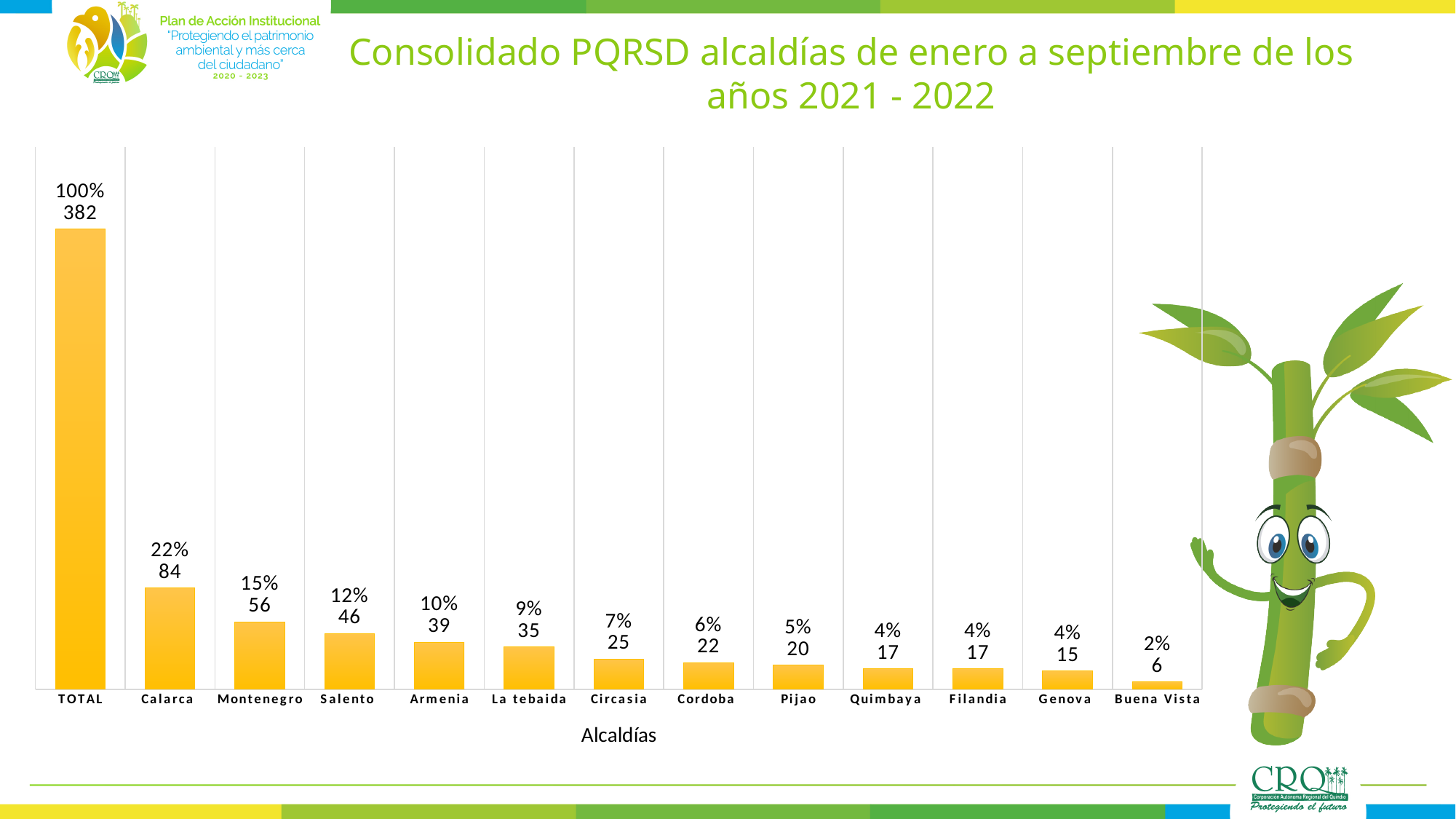
Which alcaldía has the lowest value? Buena Vista What is the value shown for the TOTAL bar? 382 What is the x-axis title of the chart? Alcaldías What kind of chart is shown on the slide? Bar chart What percentage is shown for Montenegro? 15% What is the difference between the values for Calarca and Montenegro? 28 What is the value for Armenia? 39 Which is larger, the value for Salento or the value for La tebaida? Salento How many bars are shown in the chart, including TOTAL? 13 What is the value for Calarca? 84 Excluding the TOTAL bar, which alcaldía has the highest value? Calarca What percentage is shown for Buena Vista? 2%